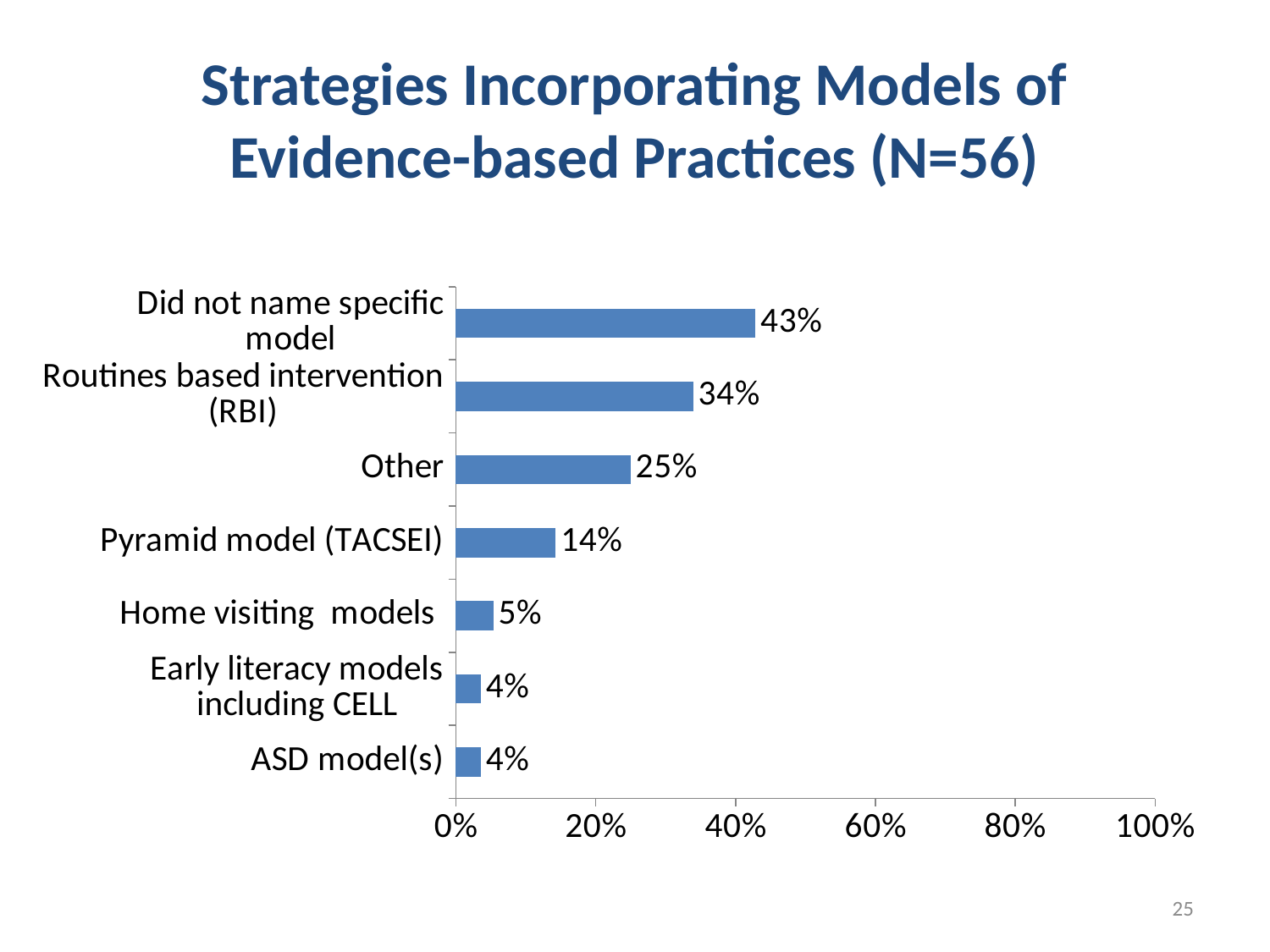
What is the difference between the values for Did not name specific model and Routines based intervention (RBI)? 9% What is the title of the chart? Strategies Incorporating Models of Evidence-based Practices (N=56) What is the value for Pyramid model (TACSEI)? 14% Which is larger, the value for Other or the value for Pyramid model (TACSEI)? Other What percentage is shown for Home visiting models? 5% How many categories are shown in the chart? 7 Which category has the highest value? Did not name specific model What is the difference between the values for Other and Pyramid model (TACSEI)? 11% What percentage is shown for Routines based intervention (RBI)? 34% Is the value for Did not name specific model greater or less than 40%? greater What kind of chart is shown on the slide? Bar chart What is the maximum value shown on the x axis? 100%